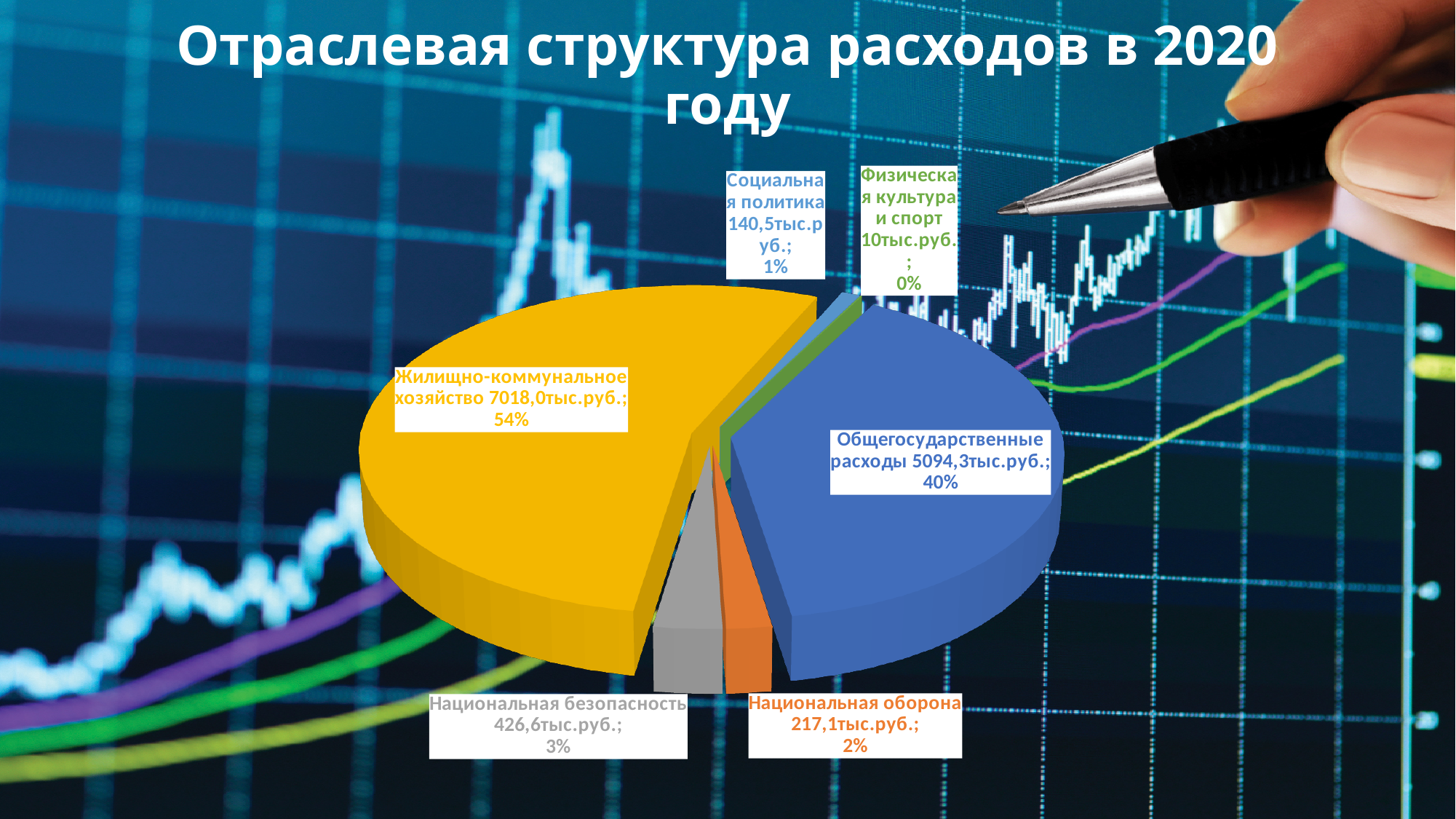
What is the value for Социальная политика? 140,5тыс.руб. What share of the pie does Общегосударственные расходы represent? 40% Which is larger: the value for Национальная безопасность or Национальная оборона? Национальная безопасность Which category has the largest share of expenditures? Жилищно-коммунальное хозяйство How many categories (slices) does the pie chart have? 6 Which category has the smallest share of expenditures? Физическая культура и спорт What is the value for Общегосударственные расходы? 5094,3тыс.руб. What is the value for Национальная безопасность? 426,6тыс.руб. What is the title of the chart? Отраслевая структура расходов в 2020 году What is the difference between the values for Жилищно-коммунальное хозяйство and Общегосударственные расходы? 1923,7тыс.руб. What kind of chart is shown on the slide? Pie chart What is the value for Жилищно-коммунальное хозяйство? 7018,0тыс.руб.